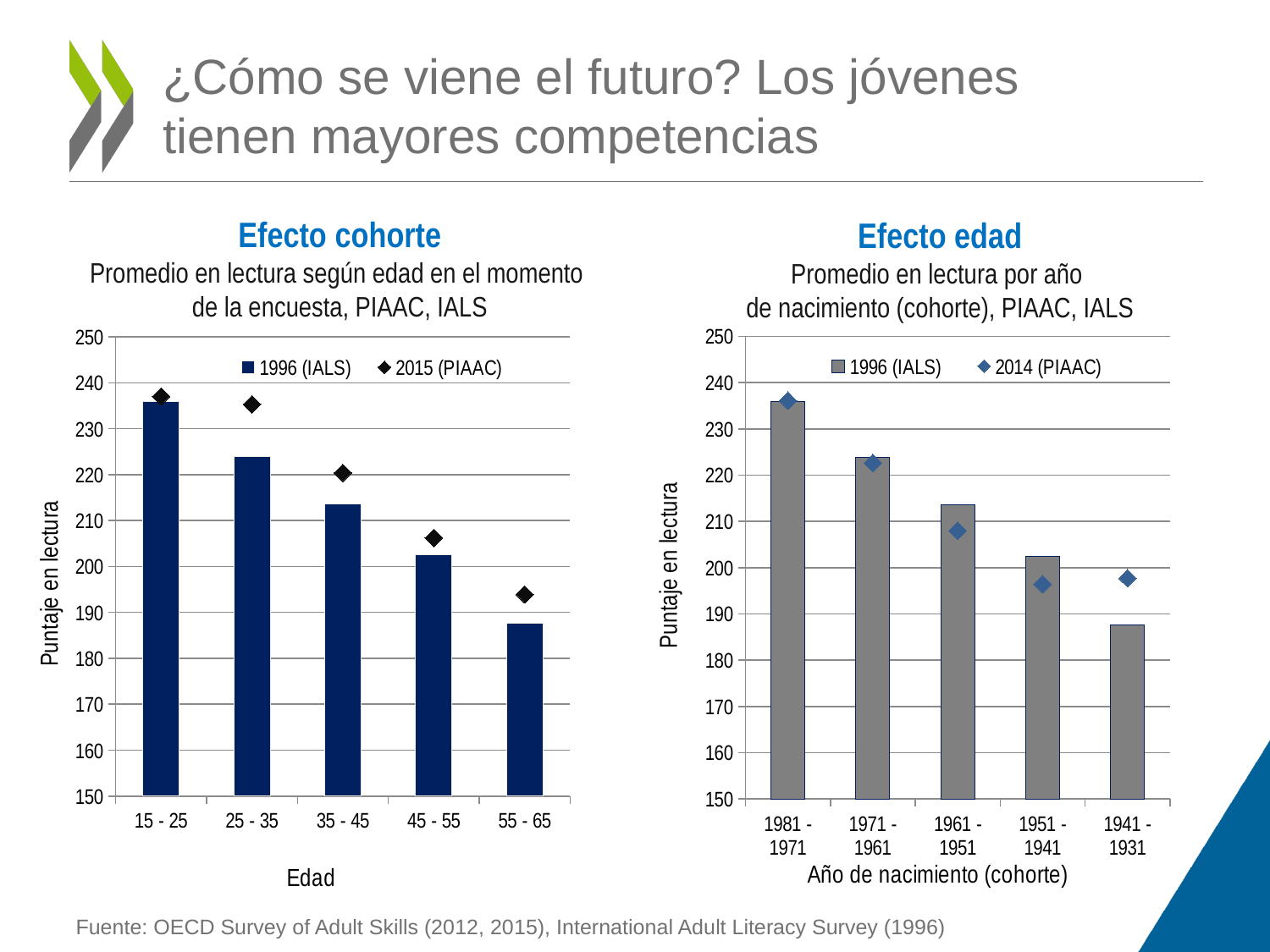
In the 'Efecto edad' chart, which is larger, the 1996 (IALS) value for 1981 - 1971 or for 1971 - 1961? 1981 - 1971 In the 'Efecto cohorte' chart, how many series does the legend list? 2 In the 'Efecto cohorte' chart, is the 2015 (PIAAC) value for 55 - 65 greater or less than 200? less In the 'Efecto cohorte' chart, which age group has the lowest 1996 (IALS) value? 55 - 65 In the 'Efecto cohorte' chart, do the 1996 (IALS) values rise or fall as age increases along the x axis? fall In the 'Efecto cohorte' chart, is the 1996 (IALS) value for 25 - 35 greater or less than 220? greater In the 'Efecto edad' chart, how many birth cohorts are shown on the x axis? 5 In the 'Efecto cohorte' chart, how many age categories are shown on the x axis? 5 In the 'Efecto edad' chart, is the 2014 (PIAAC) value for 1961 - 1951 greater or less than 200? greater What kind of chart is the 'Efecto cohorte' chart on the left? bar chart In the 'Efecto edad' chart, how many series does the legend list? 2 In the 'Efecto cohorte' chart, which age group has the highest 1996 (IALS) value? 15 - 25